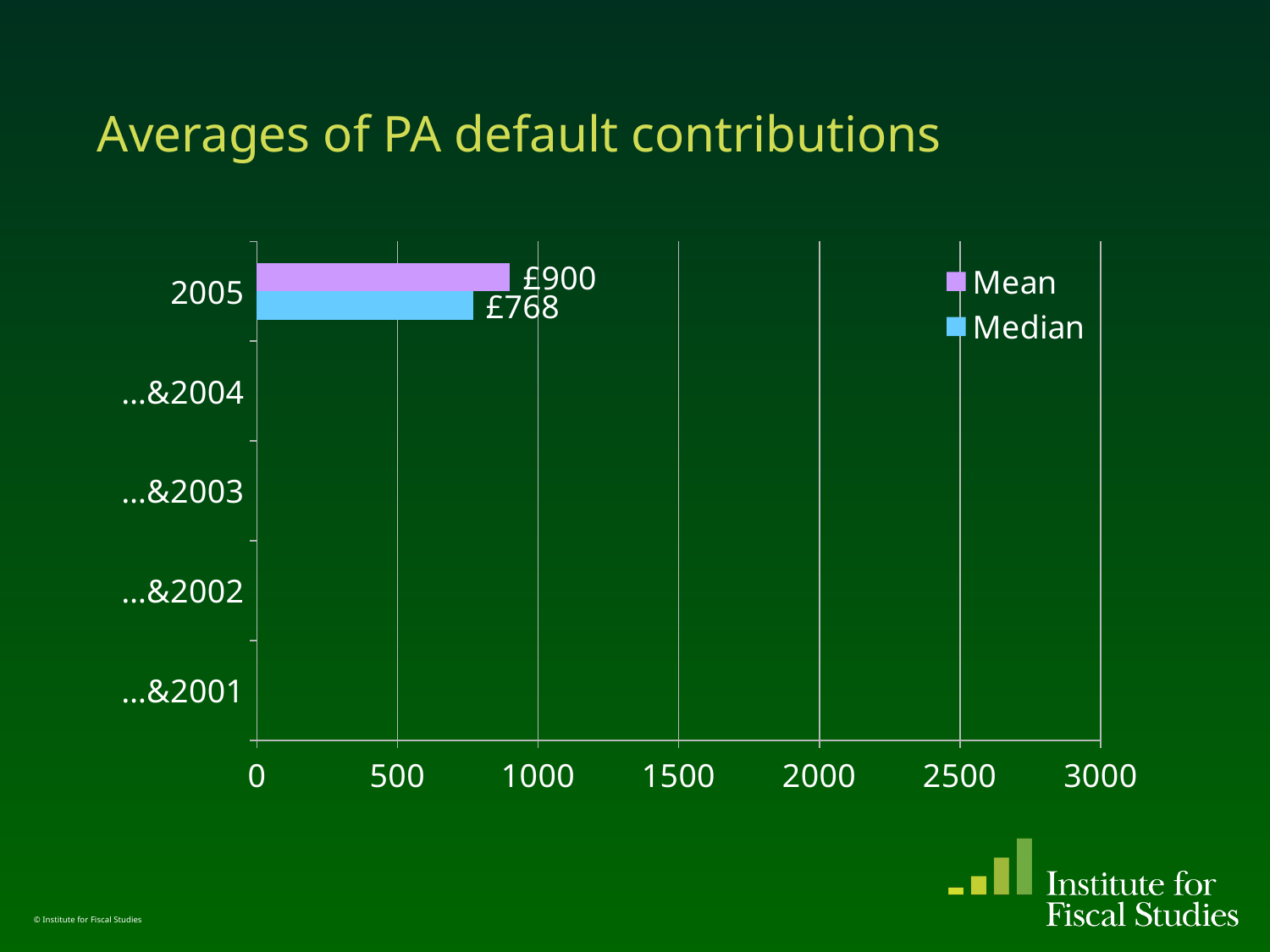
What is the difference between the Mean and Median values for 2005? £132 For 2005, which is larger, the Mean or the Median? Mean What is the title of the chart? Averages of PA default contributions What is the highest value shown on the horizontal axis? 3000 Which series is shown in blue in the legend? Median Is the Mean value for 2005 greater or less than 1000? less How many categories are listed on the vertical axis? 5 What is the Mean value for 2005? £900 Is the Median value for 2005 greater or less than 500? greater What kind of chart is shown on the slide? bar chart How many series does the legend list? 2 What is the Median value for 2005? £768